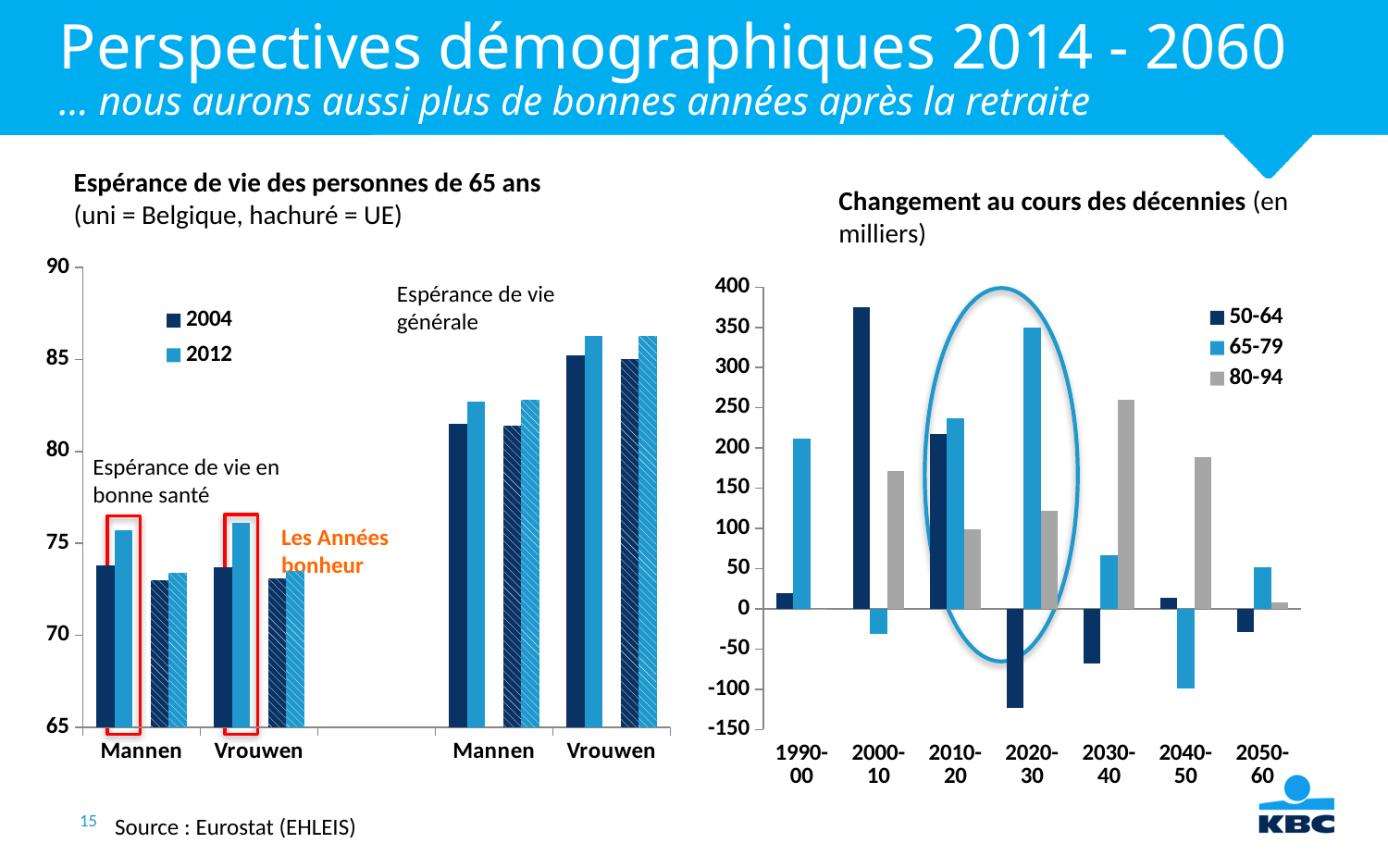
In the chart 'Espérance de vie des personnes de 65 ans', how many series does the legend list? 2 In the chart 'Changement au cours des décennies', which series has the highest value for 2030-40? 80-94 In the chart 'Changement au cours des décennies', is the 65-79 value for 2040-50 greater or less than -50? less How many decade categories are shown on the x axis of the chart 'Changement au cours des décennies'? 7 In the chart 'Espérance de vie des personnes de 65 ans', for general life expectancy in Belgium in 2012, which is larger: Mannen or Vrouwen? Vrouwen In the chart 'Espérance de vie des personnes de 65 ans', is the 2012 Belgian healthy life expectancy (solid bar) for Vrouwen greater or less than 75? greater What kind of chart is 'Changement au cours des décennies'? bar chart In the chart 'Changement au cours des décennies', is the 50-64 value for 2020-30 greater or less than -100? less In the chart 'Changement au cours des décennies', how many series does the legend list? 3 In the chart 'Changement au cours des décennies', which decade has the highest value for the 50-64 series? 2000-10